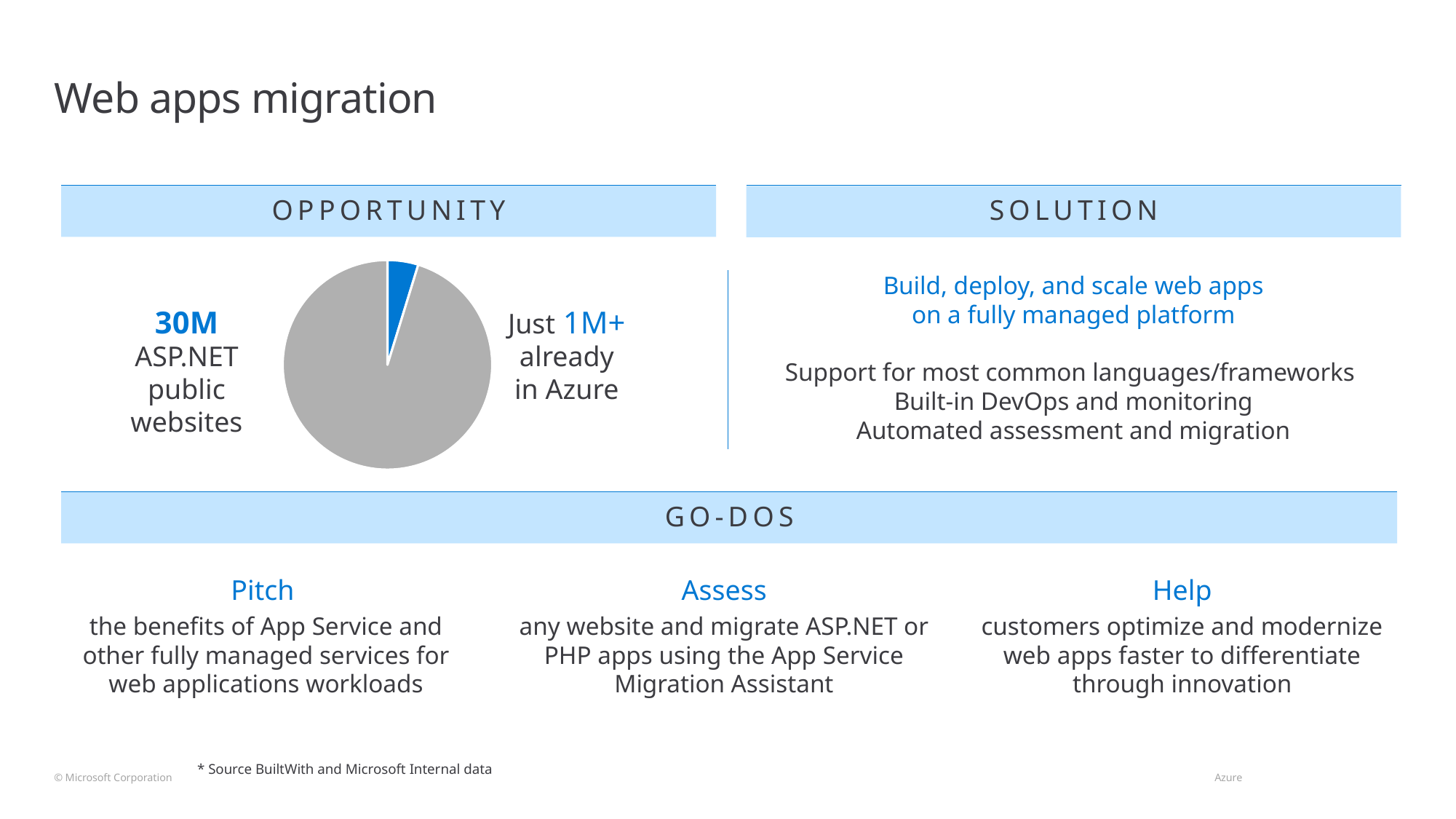
Which slice of the pie chart is the smallest? already in Azure What kind of chart is shown in the Opportunity section? pie chart What colour is the slice representing the 30M ASP.NET public websites? gray How many websites are labelled as already in Azure on the pie chart? 1M+ How many ASP.NET public websites does the pie chart label indicate? 30M How many slices does the pie chart have? 2 What colour is the slice representing websites already in Azure? blue Which slice of the pie chart is the largest? ASP.NET public websites Which slice of the pie chart is larger: ASP.NET public websites or websites already in Azure? ASP.NET public websites